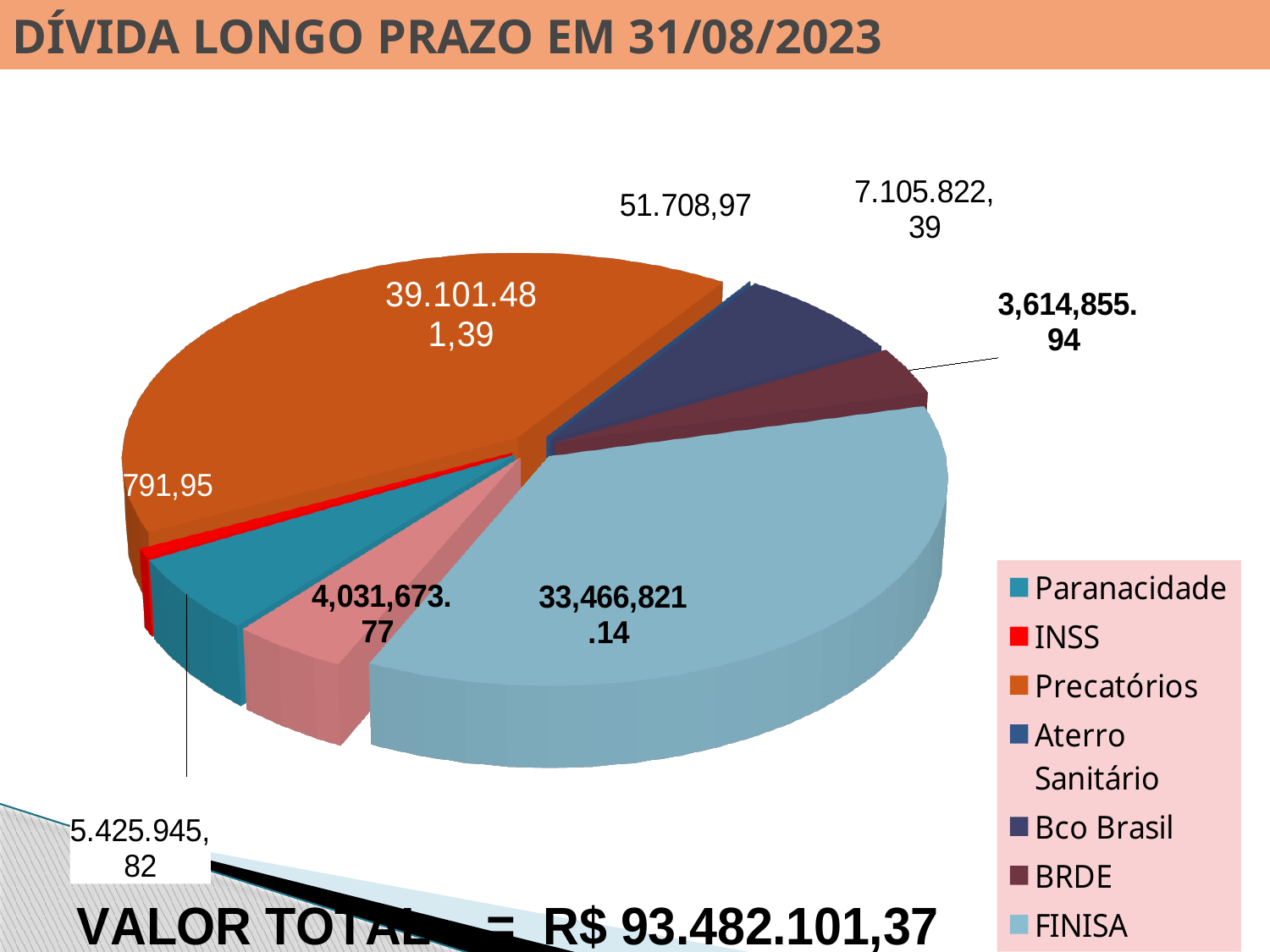
What is the value shown for Paranacidade? 5.425.945,82 What is the title of the chart on the slide? DÍVIDA LONGO PRAZO EM 31/08/2023 Which is larger, the value for Paranacidade or the value for BRDE? Paranacidade How many entries does the chart legend list? 7 What total value (VALOR TOTAL) is stated on the slide? R$ 93.482.101,37 What colour is used for the Precatórios slice? orange Which is larger, the slice for Precatórios or the slice for FINISA? Precatórios What kind of chart is shown on the slide? pie chart What is the value shown for FINISA? 33,466,821.14 Which category has the largest slice of the pie? Precatórios What is the value shown for BRDE? 3,614,855.94 What is the value shown for Precatórios? 39.101.481,39